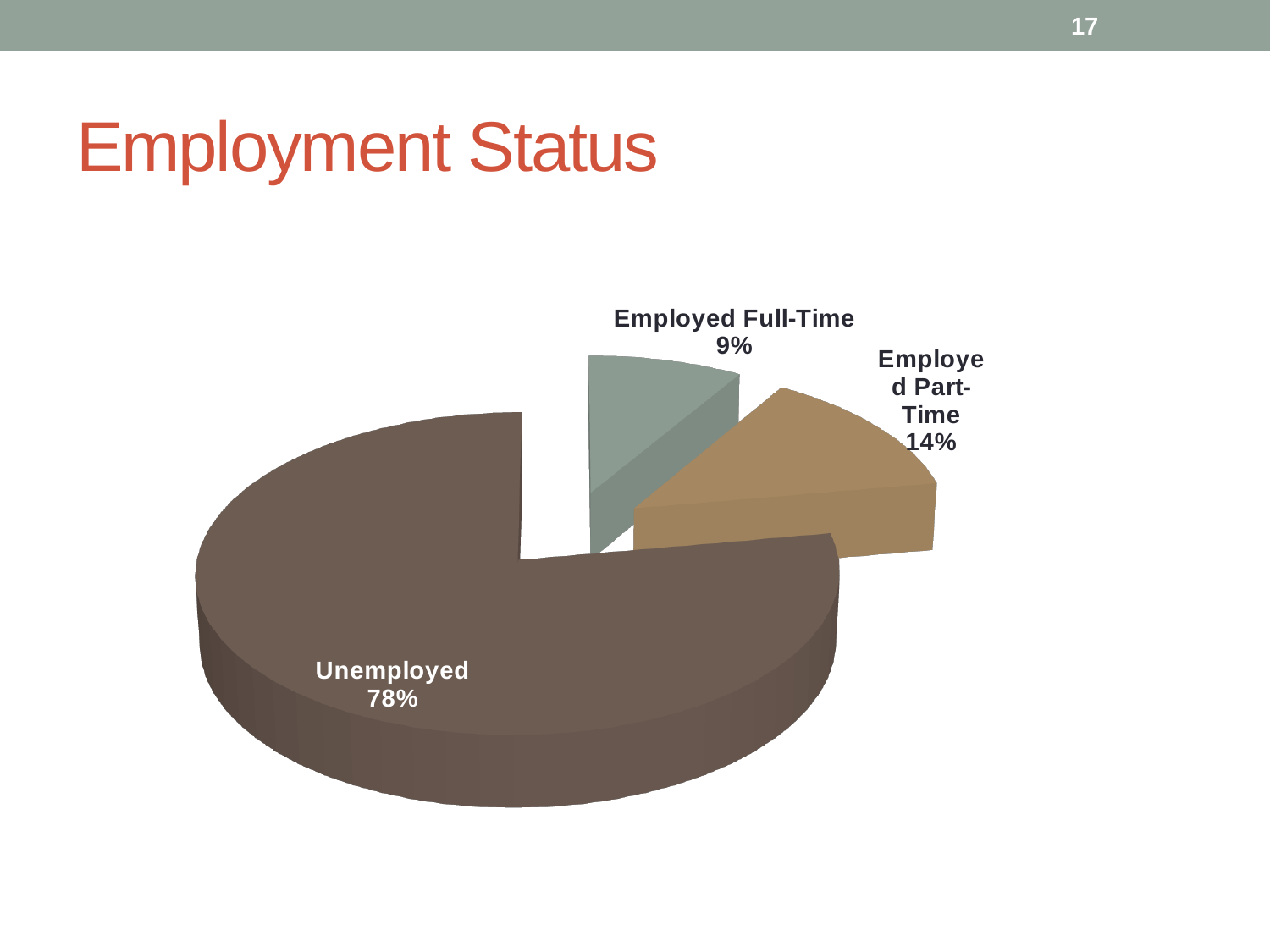
Which is larger, the share for Employed Part-Time or Employed Full-Time? Employed Part-Time What percentage of the pie is Unemployed? 78% What is the title of the slide containing the pie chart? Employment Status How many slices does the pie chart have? 3 Which category has the smallest share of the pie? Employed Full-Time What colour is the Unemployed slice? Dark brown What percentage of the pie is Employed Full-Time? 9% What percentage of the pie is Employed Part-Time? 14% What is the difference in percentage points between Employed Part-Time and Employed Full-Time? 5 What kind of chart is shown on the slide? Pie chart Which category has the largest share of the pie? Unemployed What is the difference in percentage points between Unemployed and Employed Part-Time? 64